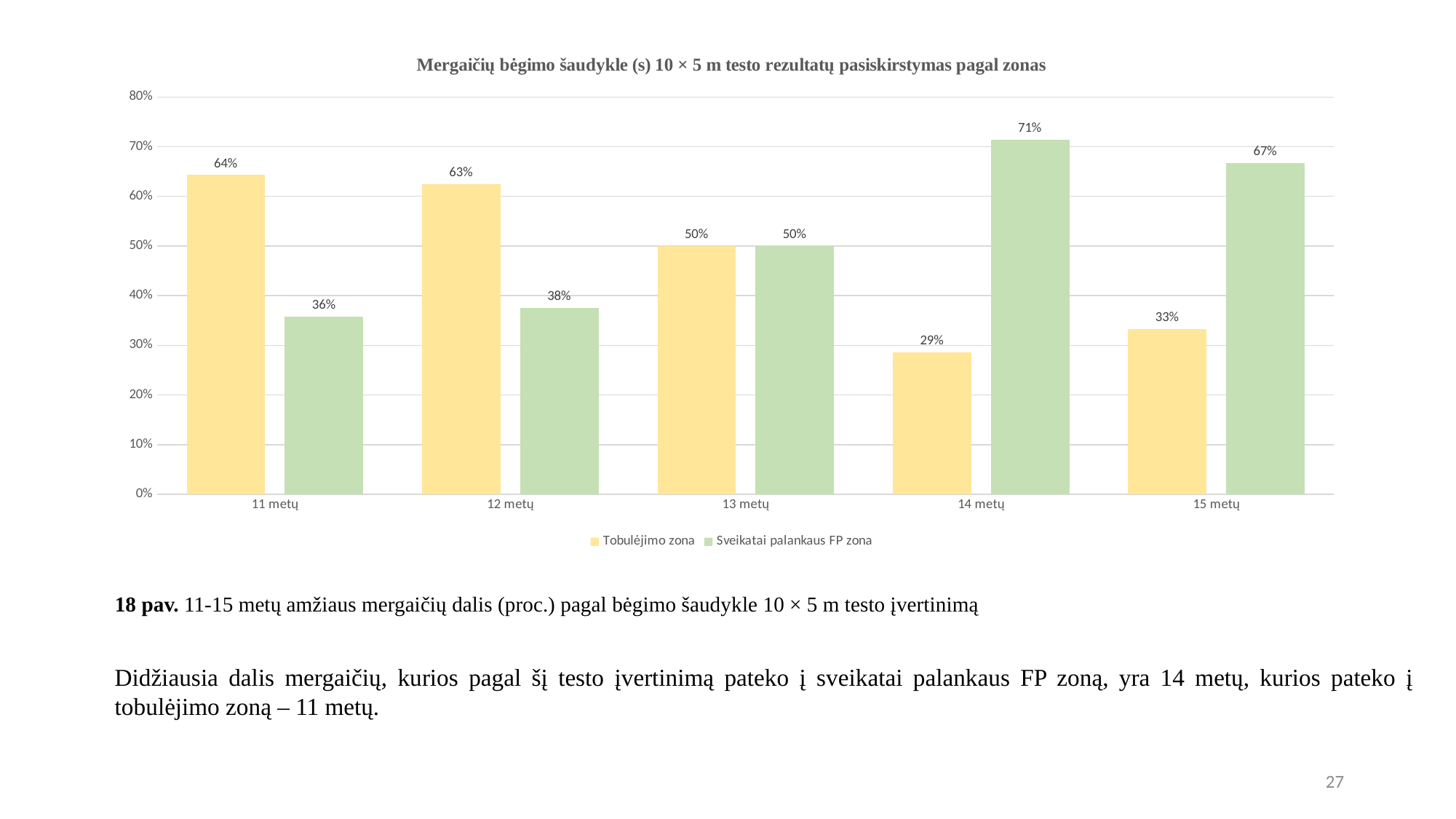
What is the value for Sveikatai palankaus FP zona at 14 metų? 71% At 15 metų, which series has the larger value: Tobulėjimo zona or Sveikatai palankaus FP zona? Sveikatai palankaus FP zona Which age group has the lowest value for Tobulėjimo zona? 14 metų How many series does the legend list? 2 What kind of chart is shown on the slide? Bar chart What is the value for Tobulėjimo zona at 11 metų? 64% Which age group has the highest value for Sveikatai palankaus FP zona? 14 metų Do the Tobulėjimo zona values generally rise or fall from 11 metų to 14 metų? Fall How many age groups are shown on the x axis? 5 What is the value for Sveikatai palankaus FP zona at 12 metų? 38% Is the value for Tobulėjimo zona at 12 metų greater or less than 60%? greater What is the difference between the Tobulėjimo zona and Sveikatai palankaus FP zona values at 11 metų? 28%